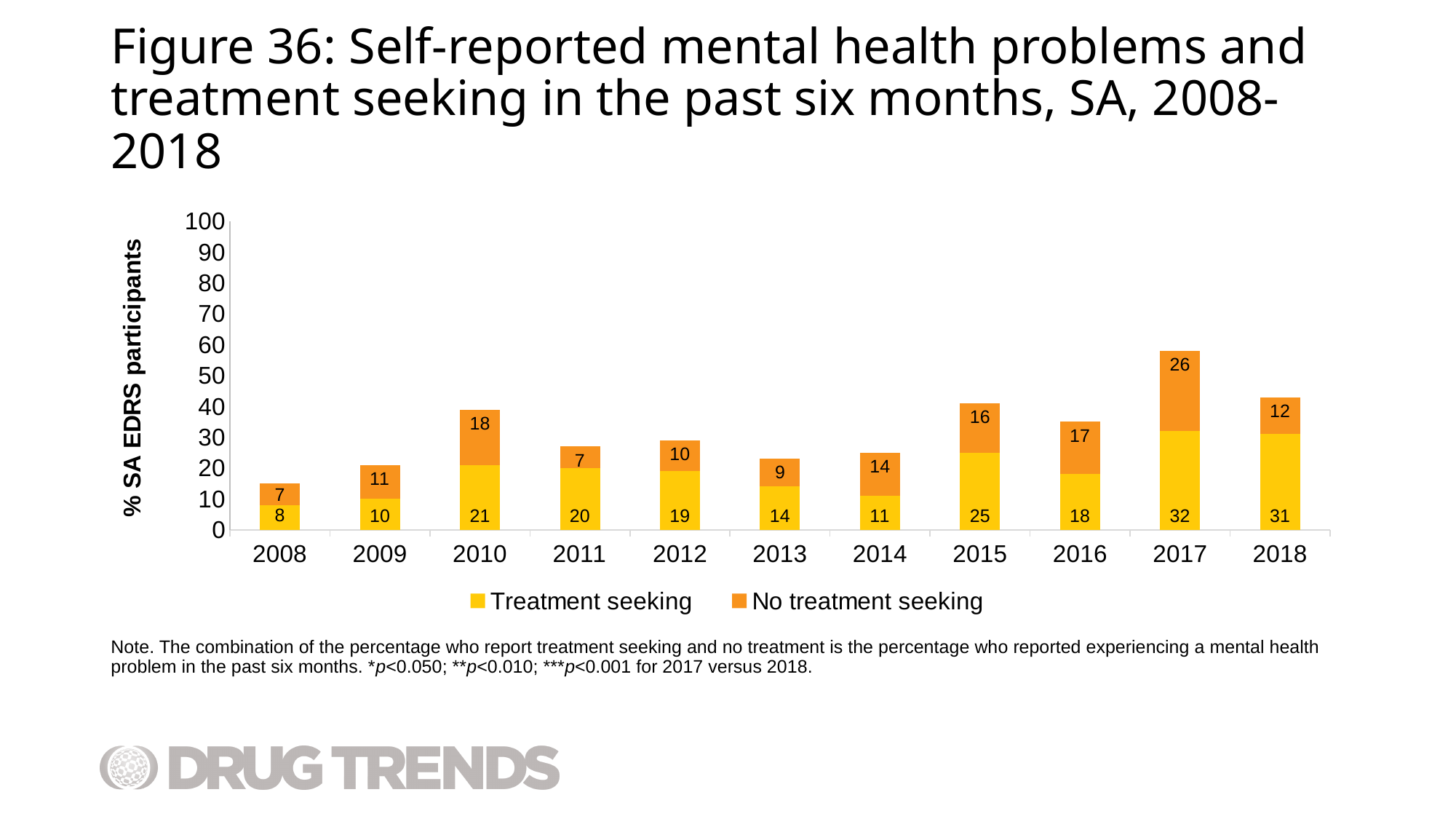
How many years are shown on the x axis? 11 How many series does the legend list? 2 Which year has the lowest value for No treatment seeking? 2008 and 2011 (both 7) What is the value for Treatment seeking in 2017? 32 What is the total of the stacked bar for 2008? 15 What kind of chart is shown on the slide? Stacked bar chart Which is larger: the No treatment seeking value for 2015 or for 2018? 2015 What is the difference between the Treatment seeking values for 2017 and 2016? 14 What is the label of the y axis? % SA EDRS participants Which year has the highest value for Treatment seeking? 2017 What is the value for No treatment seeking in 2010? 18 What is the total of the stacked bar for 2017? 58